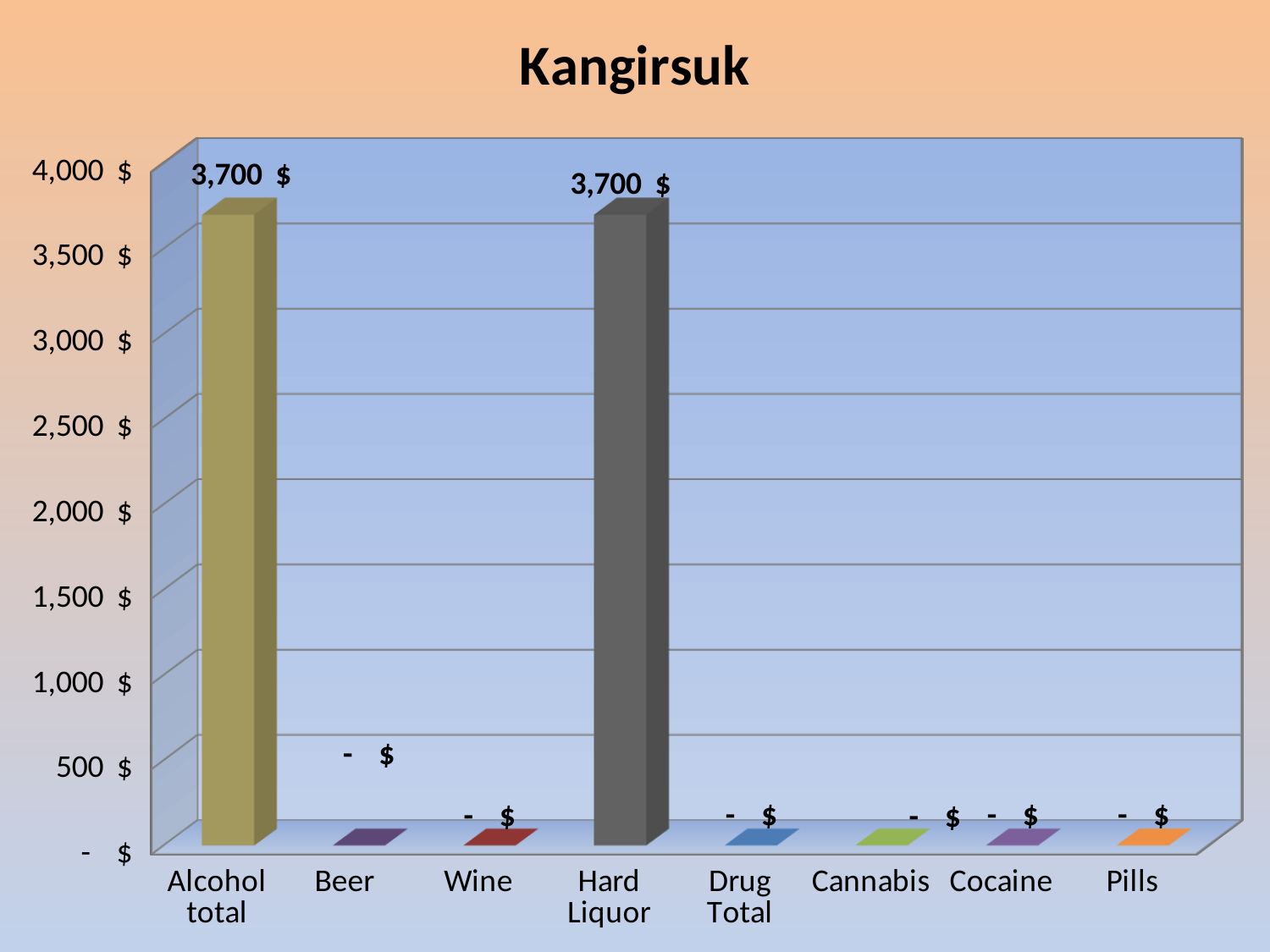
What is the value for Hard Liquor? 3,700 $ What is the value shown for Drug Total? - $ What is the difference between the values for Alcohol total and Hard Liquor? 0 $ Is the value for Alcohol total greater or less than 4,000 $? less What kind of chart is this? Bar chart What is the title of the chart? Kangirsuk Which is larger, the value for Hard Liquor or the value for Wine? Hard Liquor How many categories are shown on the x axis? 8 What is the value shown for Beer? - $ What is the value for Alcohol total? 3,700 $ Is the value for Hard Liquor greater or less than 3,000 $? greater What is the highest value shown on the vertical axis? 4,000 $